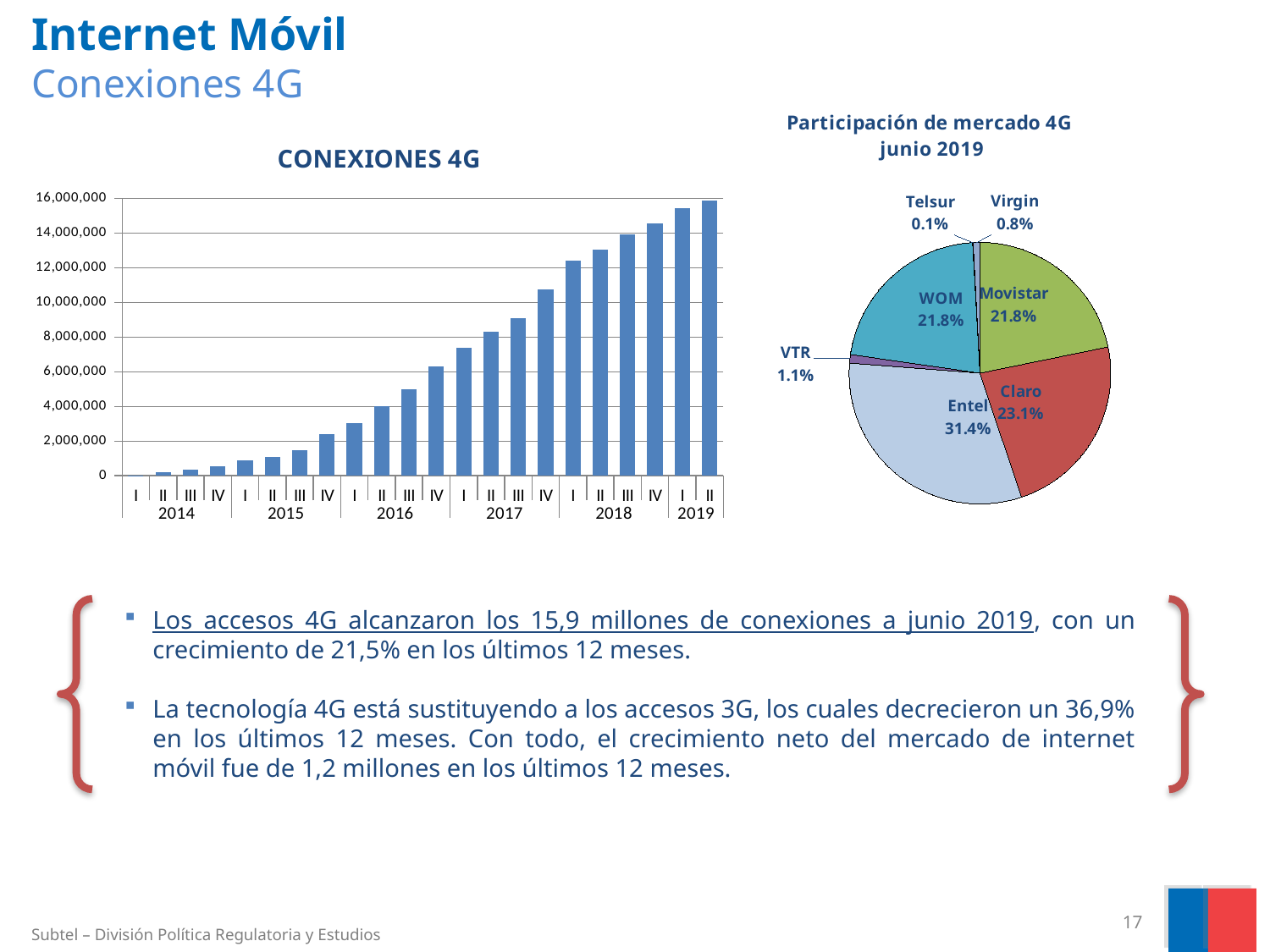
What kind of chart is the CONEXIONES 4G chart on the left? bar chart In the CONEXIONES 4G chart, is the value for quarter II of 2019 greater or less than 14,000,000? greater In the Participación de mercado 4G junio 2019 pie chart, what is the difference between Entel's share and Claro's share? 8.3% How many bars are plotted in the CONEXIONES 4G chart? 22 In the Participación de mercado 4G junio 2019 pie chart, how many operators are shown? 7 In the CONEXIONES 4G chart, is the value for quarter IV of 2014 greater or less than 2,000,000? less In the CONEXIONES 4G chart, is the value for quarter I of 2017 greater or less than 8,000,000? less In the Participación de mercado 4G junio 2019 pie chart, what is Entel's share? 31.4% In the Participación de mercado 4G junio 2019 pie chart, which operator has the smallest share? Telsur In the Participación de mercado 4G junio 2019 pie chart, which operator has the largest share? Entel In the CONEXIONES 4G chart, do the values rise or fall from 2014 to 2019? rise